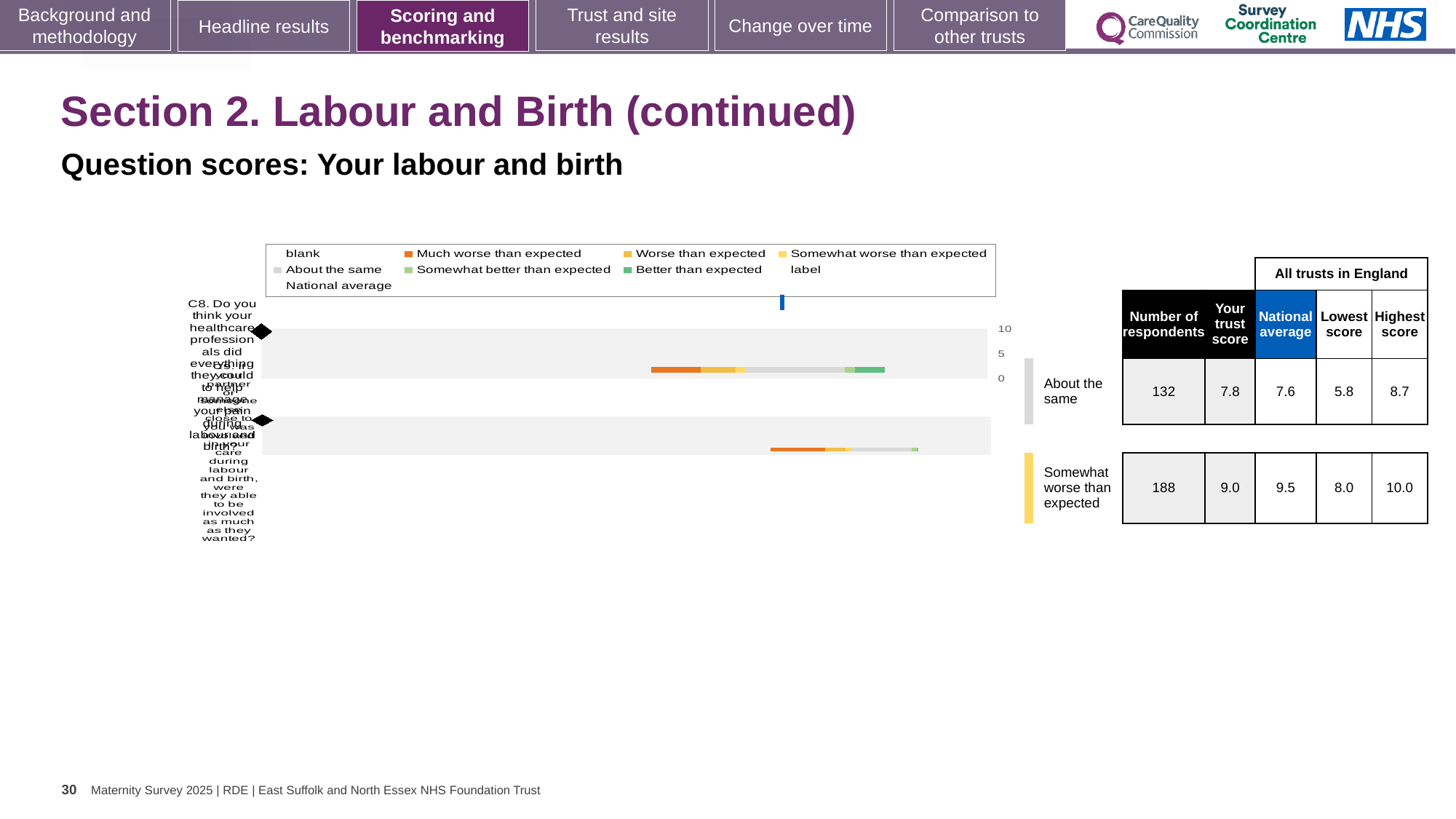
What kind of chart is shown on the slide? bar chart For the question rated 'About the same', which is larger: the trust score or the national average? trust score For the question rated 'Somewhat worse than expected', what is the difference between the national average and the trust score? 0.5 What colour represents 'Better than expected' in the chart legend? green In the table beside the chart, how many respondents are listed for the question rated 'About the same'? 132 In the table beside the chart, what is the lowest score for the question rated 'Somewhat worse than expected'? 8.0 How many question bars are plotted in the chart? 2 In the table beside the chart, what is the national average for the question rated 'About the same'? 7.6 How many entries does the chart legend list? 9 In the table beside the chart, what is the trust score for the question rated 'Somewhat worse than expected'? 9.0 In the table beside the chart, what is the highest score for the question rated 'About the same'? 8.7 What colour represents 'Much worse than expected' in the chart legend? orange